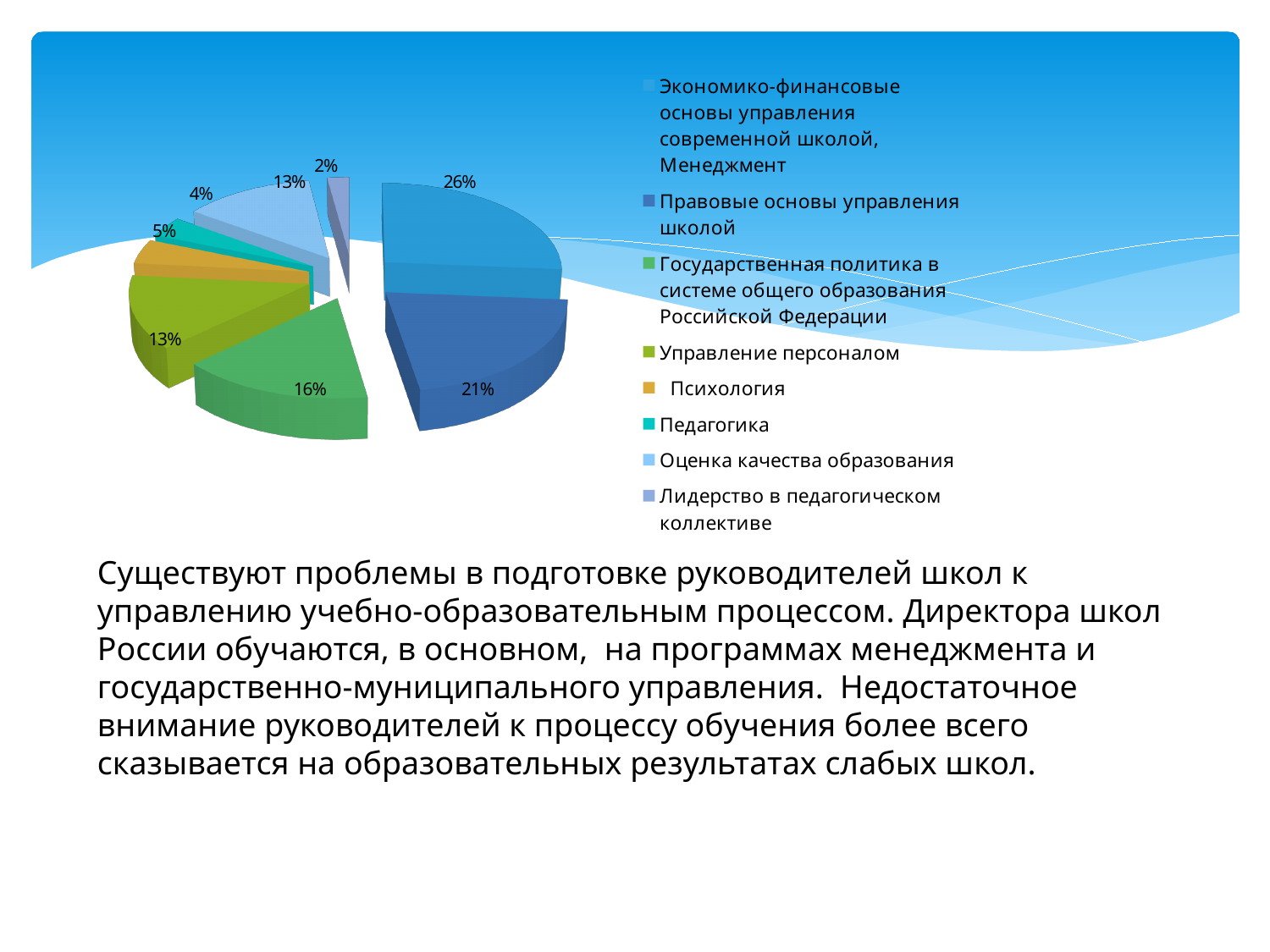
What percentage is shown for "Государственная политика в системе общего образования Российской Федерации"? 16% How many entries does the legend list? 8 What type of chart is shown on the slide? Pie chart Which category has the smallest slice of the pie? Лидерство в педагогическом коллективе What percentage is shown for "Психология"? 5% What percentage is shown for "Правовые основы управления школой"? 21% What share of the pie is labelled for "Экономико-финансовые основы управления современной школой, Менеджмент"? 26% Which is larger: the slice for "Управление персоналом" or the slice for "Психология"? Управление персоналом How many slices does the pie chart have? 8 What is the difference in percentage points between "Правовые основы управления школой" and "Государственная политика в системе общего образования Российской Федерации"? 5% Which category has the largest slice of the pie? Экономико-финансовые основы управления современной школой, Менеджмент What percentage is shown for "Педагогика"? 4%